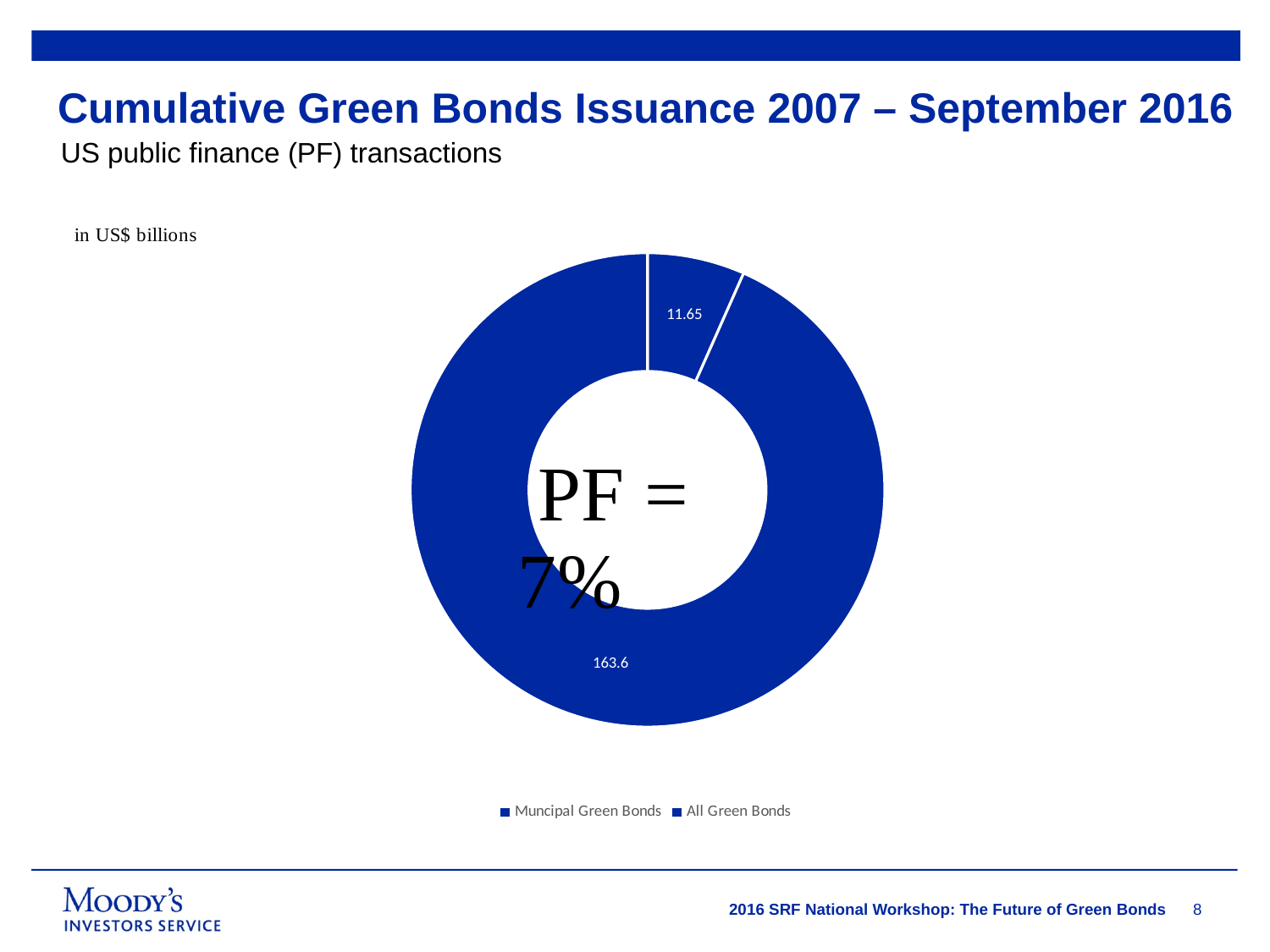
What is the value for All Green Bonds? 163.6 What is the title of the slide containing the chart? Cumulative Green Bonds Issuance 2007 – September 2016 What kind of chart is shown on the slide? doughnut chart How many entries does the legend list? 2 What is the value for Municipal Green Bonds? 11.65 How many slices does the chart have? 2 What is the difference between the All Green Bonds value and the Municipal Green Bonds value? 151.95 Which is larger, Municipal Green Bonds or All Green Bonds? All Green Bonds Which slice is the largest? All Green Bonds In what units are the chart values expressed? US$ billions Which slice is the smallest? Municipal Green Bonds What share of the total does public finance (PF) represent, according to the text in the centre of the chart? 7%